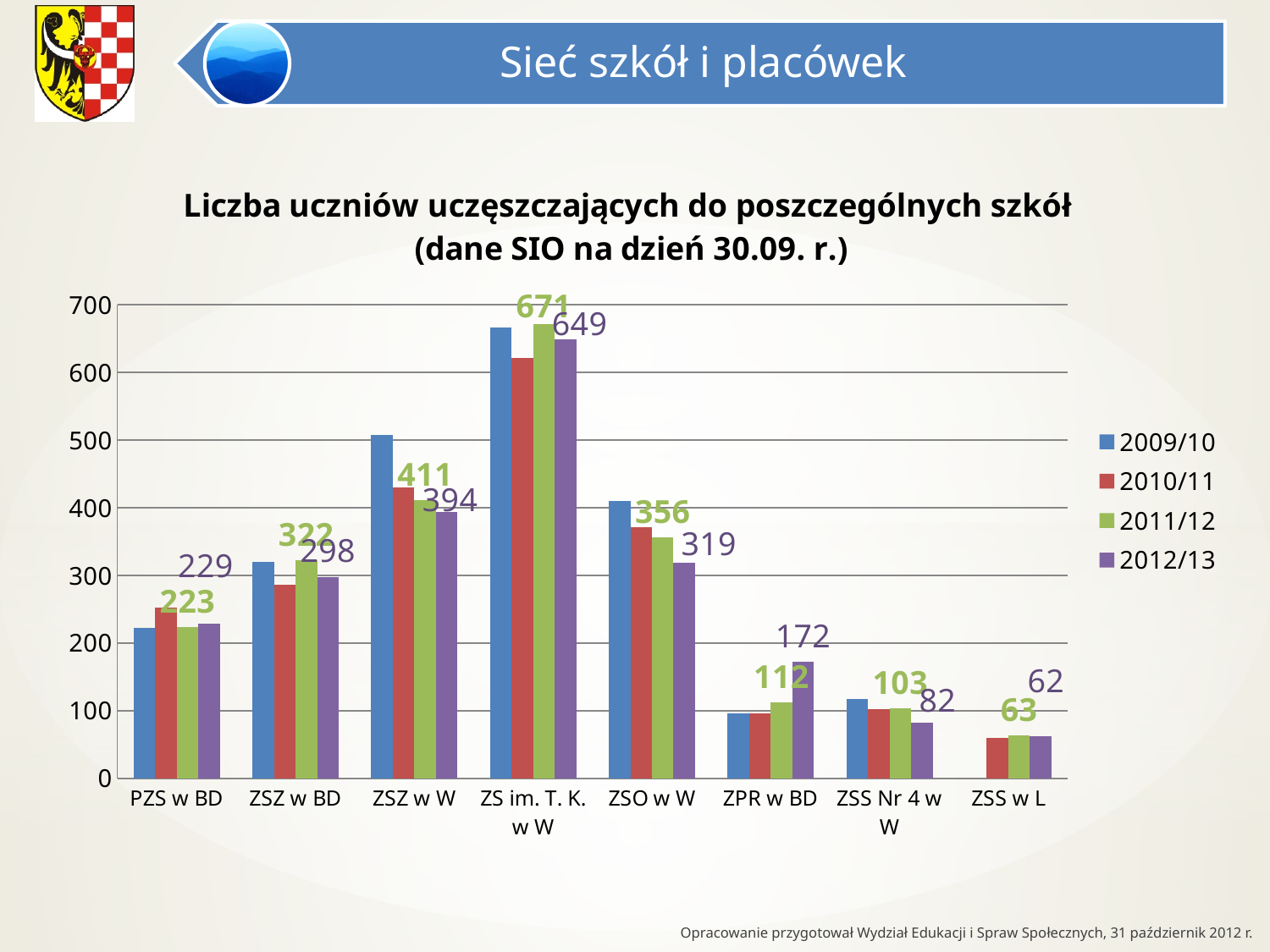
Which school has the lowest 2011/12 value? ZSS w L What is the 2012/13 value for ZPR w BD? 172 What kind of chart is shown? bar chart How many series does the legend list? 4 How many schools are shown on the x axis? 8 Which school has the highest 2012/13 value? ZS im. T. K. w W What is the difference between the 2011/12 and 2012/13 values for ZSO w W? 37 Is the 2009/10 value for ZSZ w W greater or less than 500? greater What is the 2011/12 value for ZSS Nr 4 w W? 103 Which series is shown in purple? 2012/13 What is the 2011/12 value for ZS im. T. K. w W? 671 Which is larger for ZPR w BD: the 2011/12 value or the 2012/13 value? 2012/13